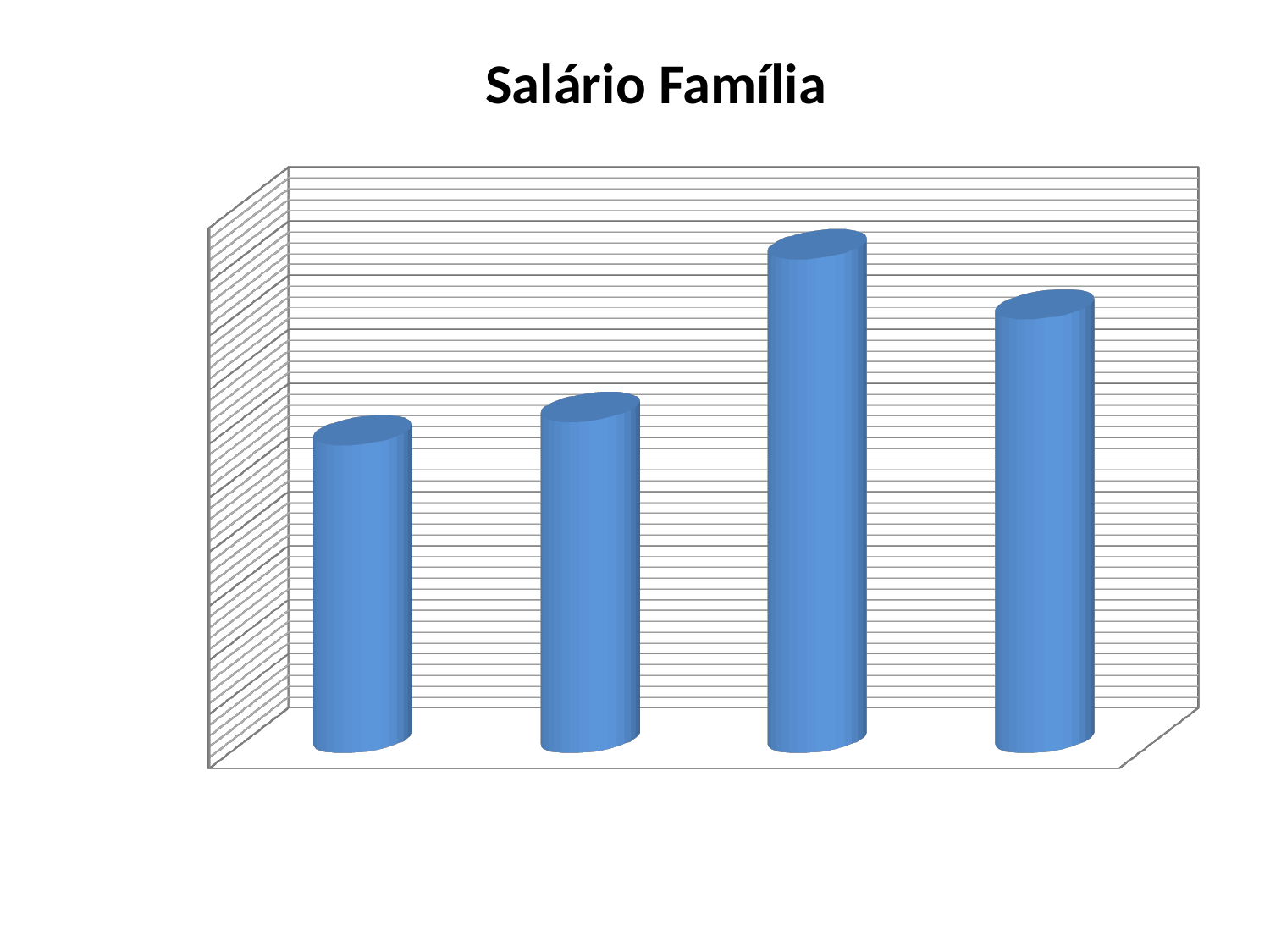
What is the title of the chart? Salário Família Do the values rise or fall from the first bar to the third bar? rise Do the values rise or fall from the third bar to the fourth bar? fall Which bar, counting from the left, is the tallest? the third bar Which is taller, the second bar or the fourth bar from the left? the fourth bar Which bar, counting from the left, is the shortest? the first bar How many bars does the chart show? 4 What kind of chart is shown on the slide? bar chart Which is taller, the third bar or the fourth bar from the left? the third bar Which is taller, the first bar or the second bar from the left? the second bar What colour are the bars in the chart? blue